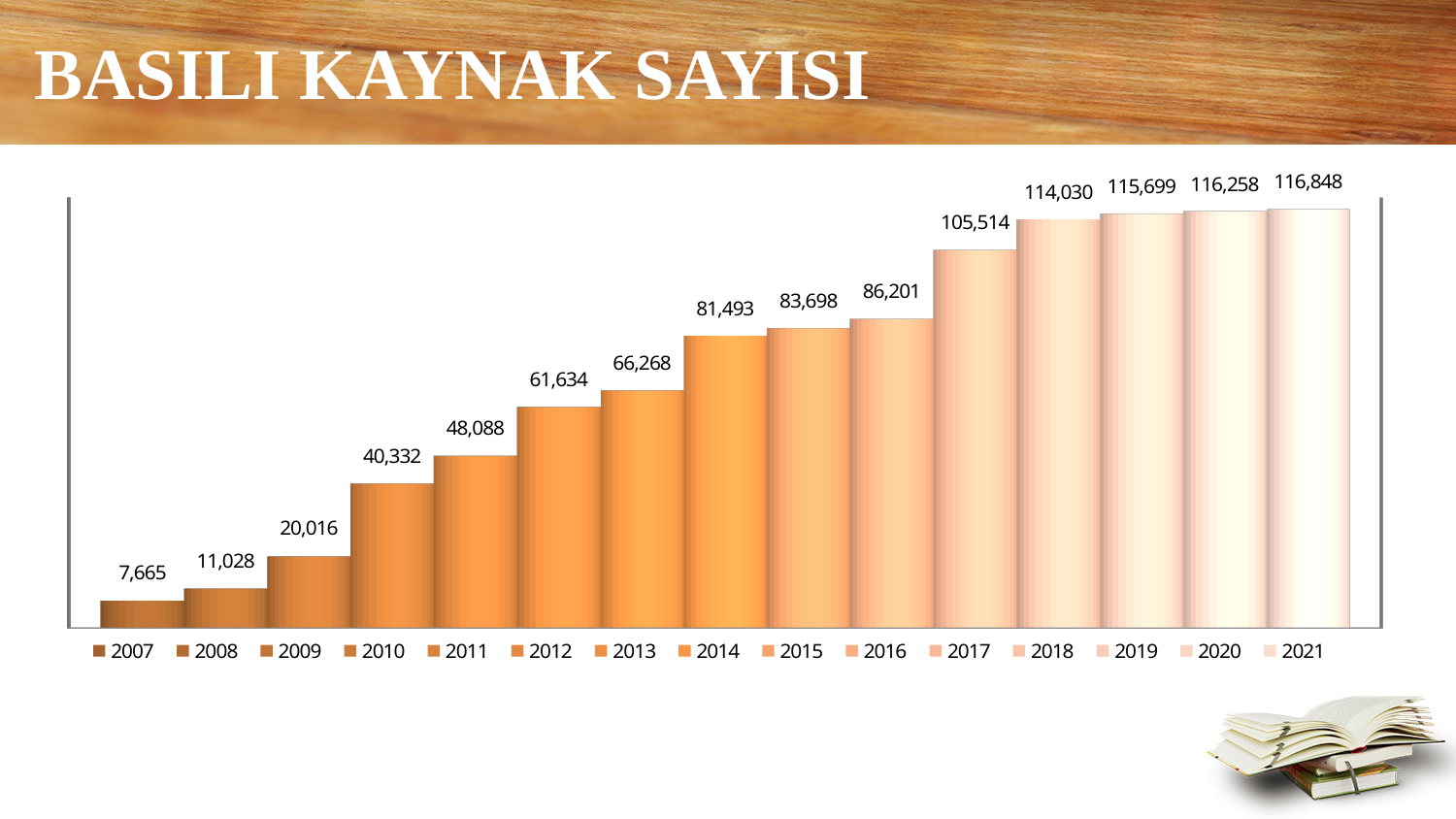
Which year has the highest value? 2021 Which year has the lowest value? 2007 What is the value for 2021? 116,848 Which is larger, the value for 2012 or the value for 2013? 2013 How many bars are plotted in the chart? 15 What kind of chart is shown on the slide? Bar chart What is the difference between the values for 2021 and 2007? 109,183 Do the values rise or fall from 2007 to 2021? Rise How many entries does the legend list? 15 What is the value for 2017? 105,514 What is the difference between the values for 2010 and 2009? 20,316 What is the value for 2007? 7,665